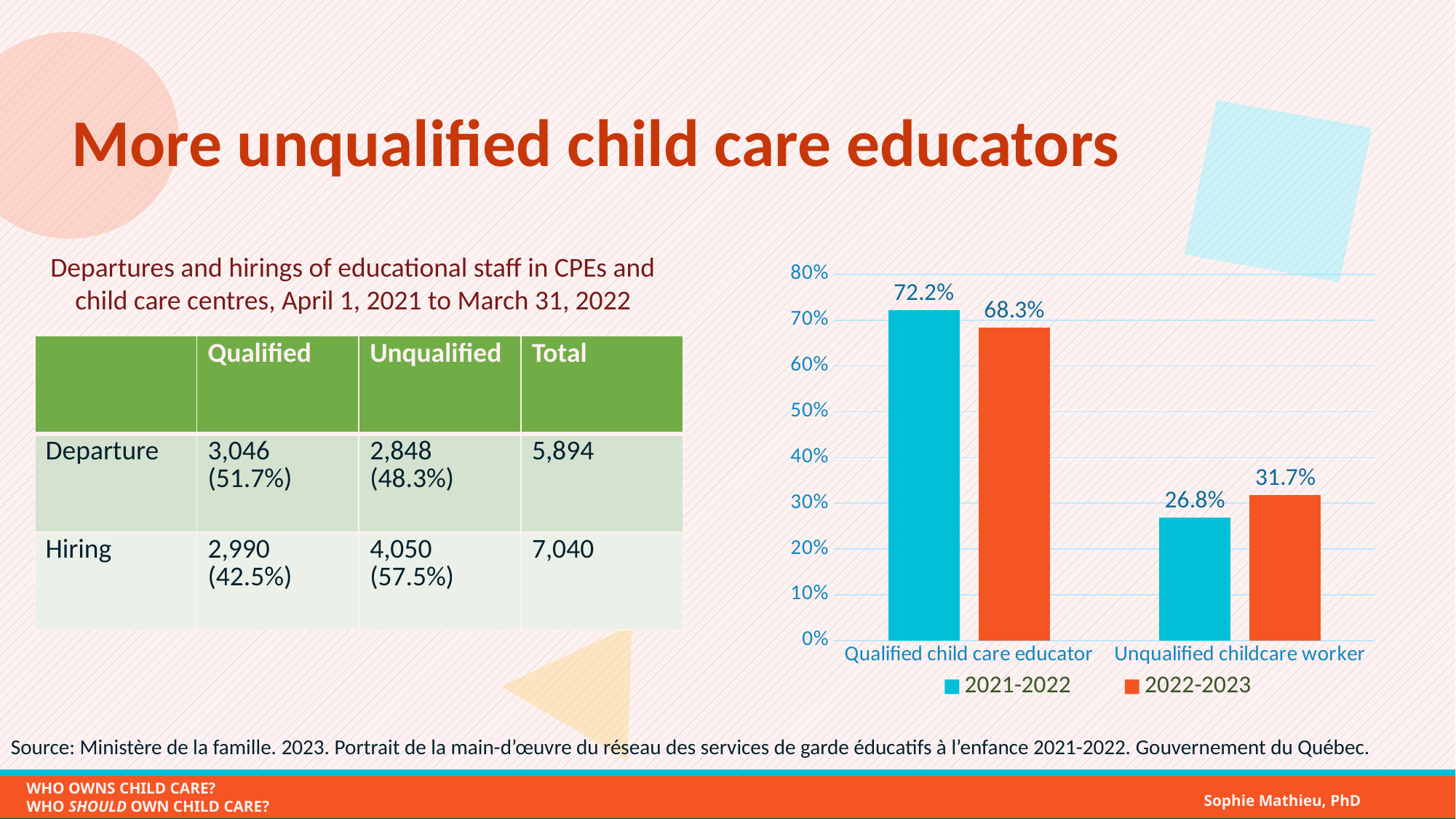
What is the difference between the 2021-2022 and 2022-2023 values for Unqualified childcare worker? 4.9% What kind of chart is shown on the slide? Bar chart What is the value for Unqualified childcare worker in 2021-2022? 26.8% Is the 2022-2023 value for Unqualified childcare worker greater or less than 30%? greater How many categories are shown on the x axis of the chart? 2 Which is larger for Qualified child care educator: the 2021-2022 value or the 2022-2023 value? 2021-2022 What is the value for Unqualified childcare worker in 2022-2023? 31.7% How many series does the chart legend list? 2 Which category has the highest value in the 2022-2023 series? Qualified child care educator Which category has the lowest value in the 2021-2022 series? Unqualified childcare worker What is the value for Qualified child care educator in 2022-2023? 68.3% What is the value for Qualified child care educator in 2021-2022? 72.2%